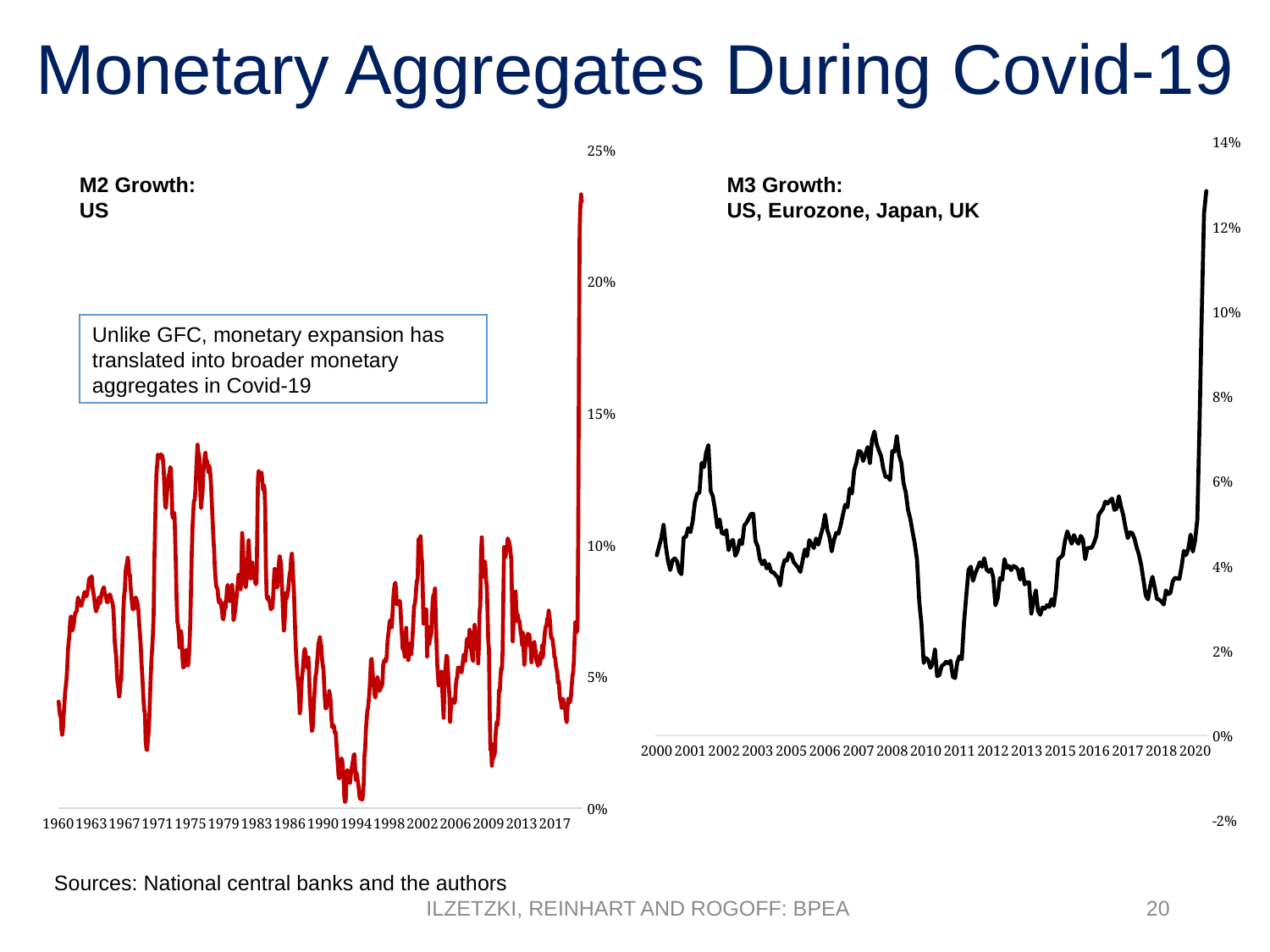
What is the highest value shown on the y-axis of the 'M2 Growth: US' chart? 25% In the 'M2 Growth: US' chart, is the value at the final spike on the right end of the series greater or less than 20%? greater What colour is the line in the 'M2 Growth: US' chart? red In the 'M3 Growth: US, Eurozone, Japan, UK' chart, does the series rise or fall between 2008 and 2010? fall What type of chart is the 'M2 Growth: US' chart on the left? line chart In the 'M2 Growth: US' chart, does the series rise or fall at the very end of the x axis? rise In the 'M3 Growth: US, Eurozone, Japan, UK' chart, is the value at the final spike in 2020 greater or less than 12%? greater In the 'M2 Growth: US' chart, is the lowest value around 1994 greater or less than 5%? less What type of chart is the 'M3 Growth: US, Eurozone, Japan, UK' chart on the right? line chart